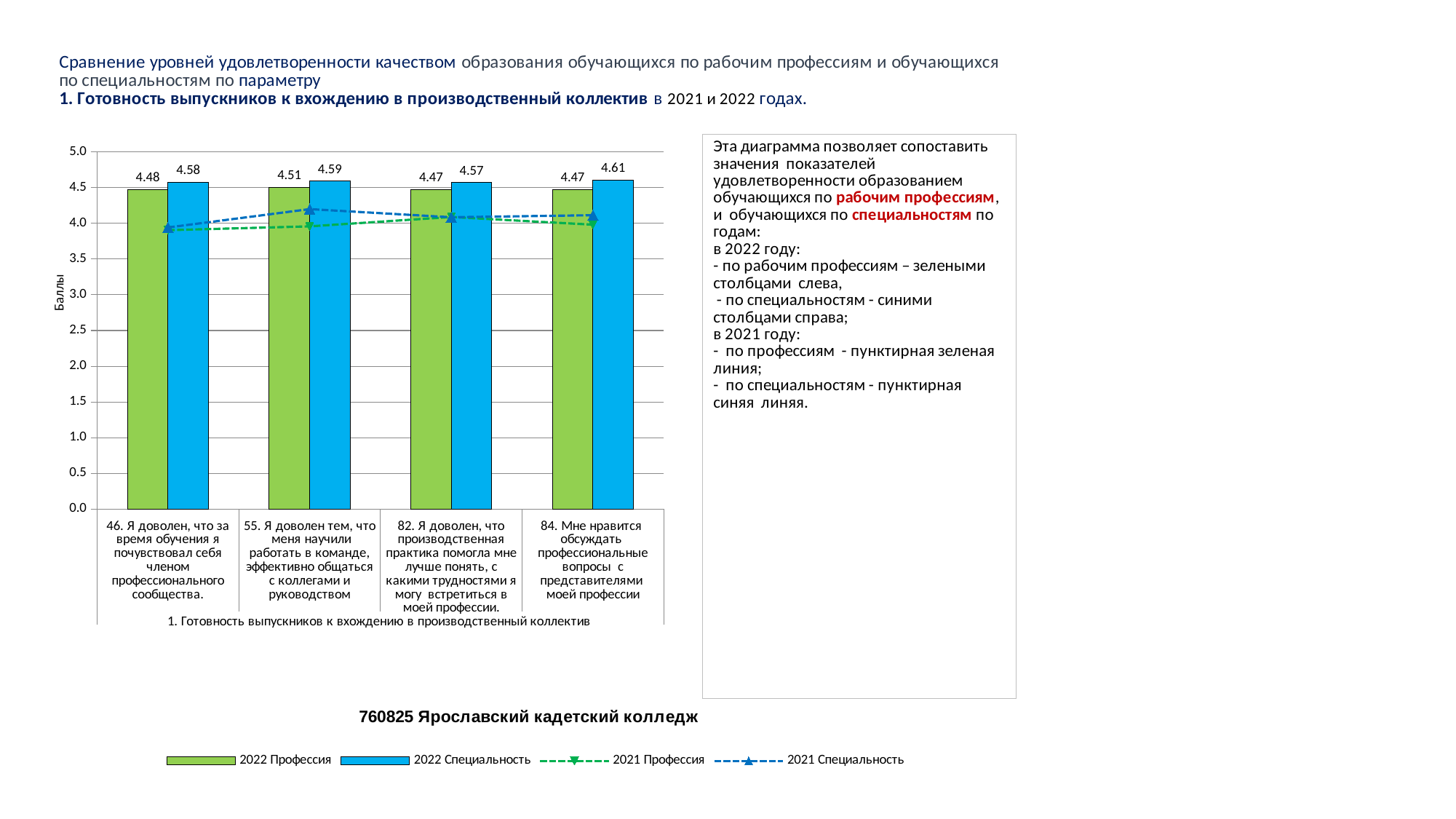
What is the value of the 2022 Профессия bar for category 46 (Я доволен, что за время обучения я почувствовал себя членом профессионального сообщества)? 4.48 What is the difference between the 2022 Специальность and 2022 Профессия bars for category 84? 0.14 Which category has the lowest 2022 Специальность bar? 82. Я доволен, что производственная практика помогла мне лучше понять, с какими трудностями я могу встретиться в моей профессии. Which is larger for category 46: the 2022 Профессия bar or the 2022 Специальность bar? 2022 Специальность Which category has the highest 2022 Профессия bar? 55. Я доволен тем, что меня научили работать в команде, эффективно общаться с коллегами и руководством What is the label of the vertical axis of the chart? Баллы Is the 2021 Профессия line value for category 46 greater or less than 4.0? less What is the value of the 2022 Специальность bar for category 84 (Мне нравится обсуждать профессиональные вопросы с представителями моей профессии)? 4.61 How many categories are shown on the x axis of the chart? 4 What is the value of the 2022 Профессия bar for category 55 (Я доволен тем, что меня научили работать в команде)? 4.51 How many series does the chart legend list? 4 Which category has the highest 2022 Специальность bar? 84. Мне нравится обсуждать профессиональные вопросы с представителями моей профессии